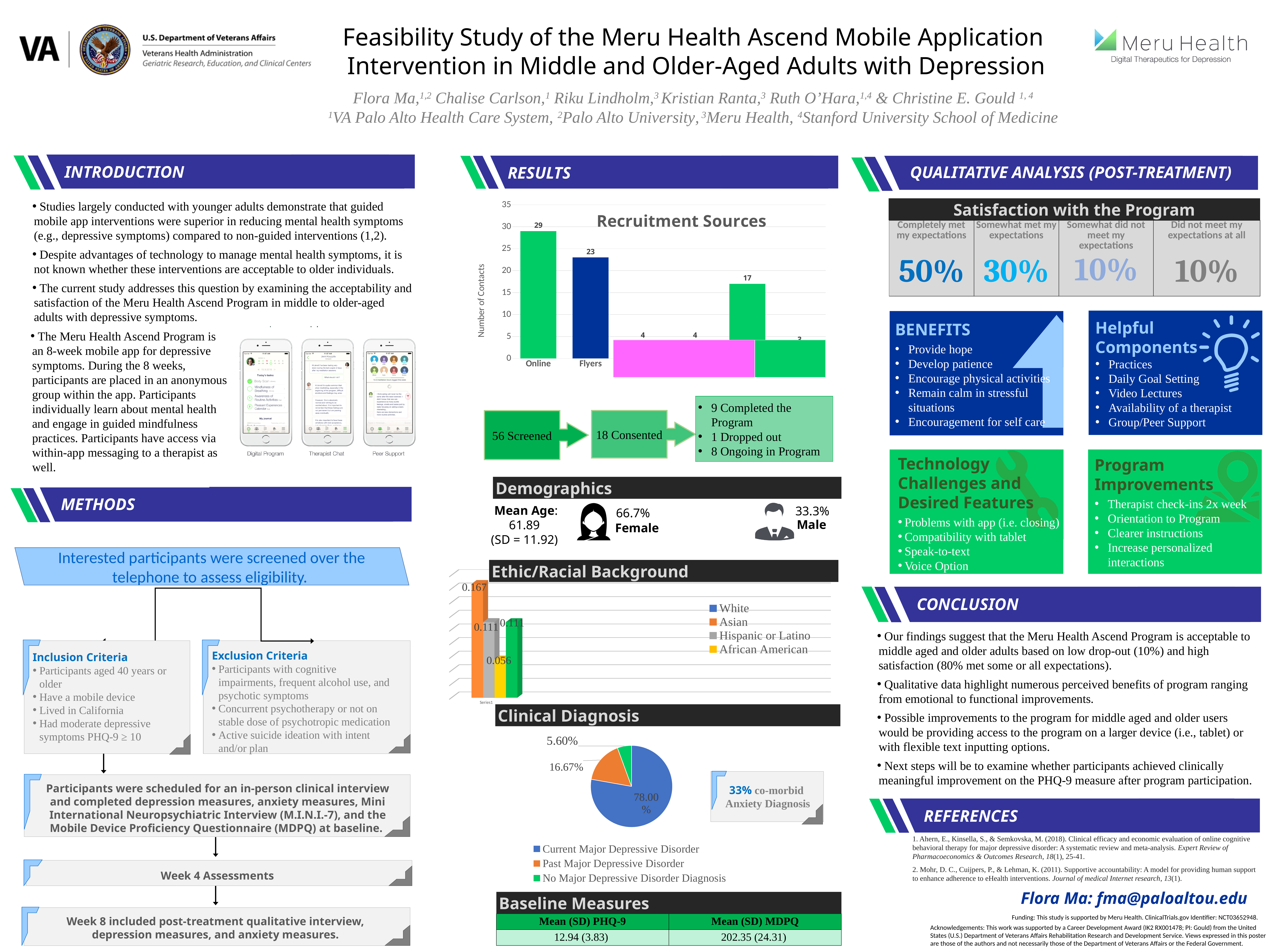
What kind of chart is the Recruitment Sources chart? Bar chart In the Recruitment Sources chart, what is the difference in contacts between Online and Flyers? 6 What is the y-axis label of the Recruitment Sources chart? Number of Contacts In the Clinical Diagnosis pie chart, what share is Past Major Depressive Disorder? 16.67% In the Clinical Diagnosis pie chart, which category has the smallest slice? No Major Depressive Disorder Diagnosis In the Recruitment Sources chart, is the value for Flyers greater or less than 20? greater In the Recruitment Sources chart, how many contacts came from Online? 29 In the Recruitment Sources chart, which labelled recruitment source has the highest number of contacts? Online How many entries does the legend of the Ethic/Racial Background chart list? 4 In the Recruitment Sources chart, which has more contacts, Online or Flyers? Online In the Recruitment Sources chart, how many contacts came from Flyers? 23 In the Clinical Diagnosis pie chart, what share is Current Major Depressive Disorder? 78.00%